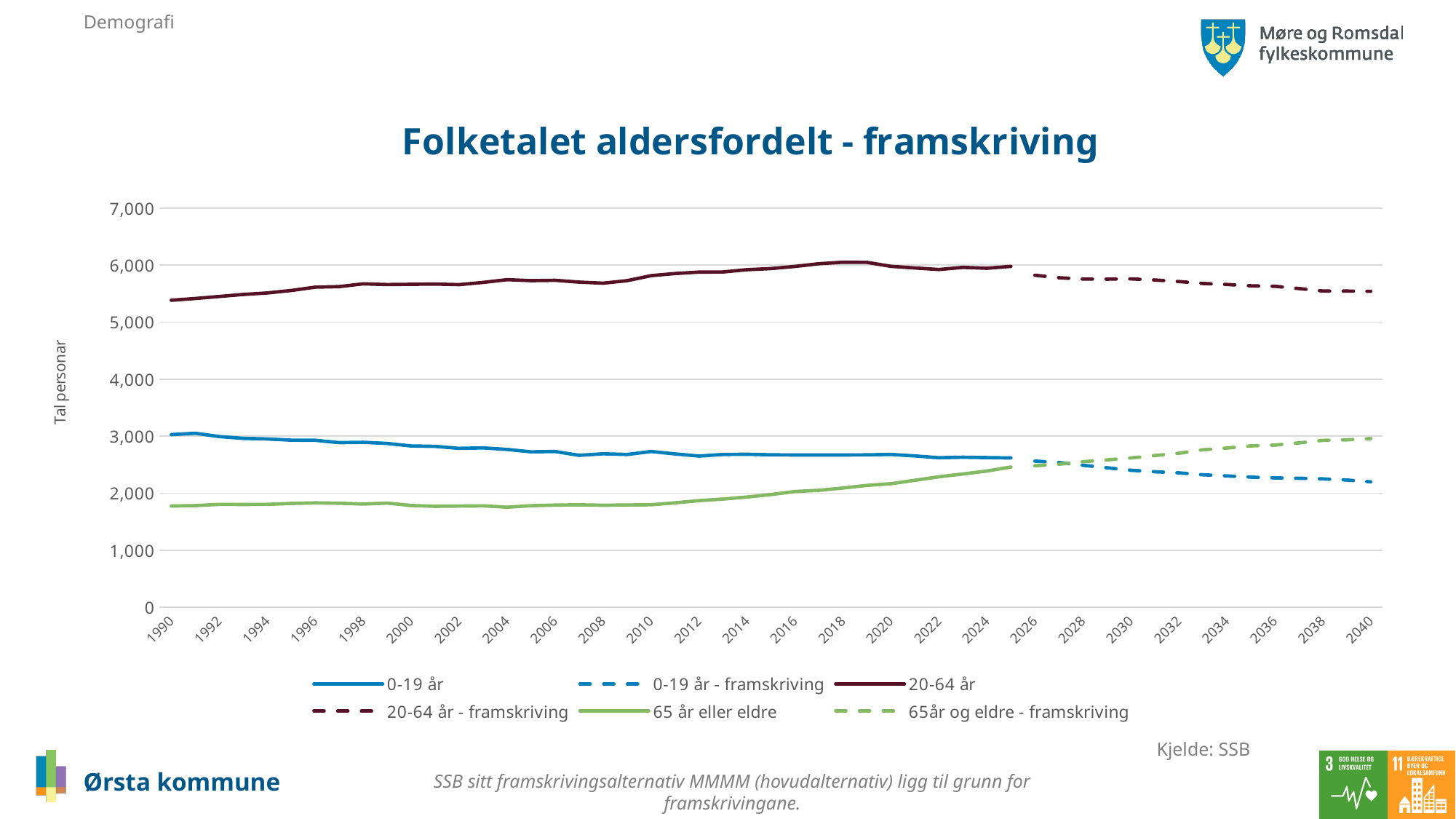
Does the '65 år eller eldre' series rise or fall between 2010 and 2024? rise What is the title of the chart? Folketalet aldersfordelt - framskriving In 2040, which is larger: '65år og eldre - framskriving' or '0-19 år - framskriving'? 65år og eldre - framskriving Is the value for '65 år eller eldre' in 1990 greater or less than 2,000? less How many series does the legend list? 6 Does the '20-64 år - framskriving' series rise or fall between 2026 and 2040? fall What kind of chart is shown on the slide? line chart Is the value for '20-64 år' in 1990 greater or less than 5,000? greater What is the label on the y axis of the chart? Tal personar Does the '0-19 år' series rise or fall between 1990 and 2024? fall Which series has the highest values across the whole chart? 20-64 år In 1990, which is larger: '0-19 år' or '65 år eller eldre'? 0-19 år